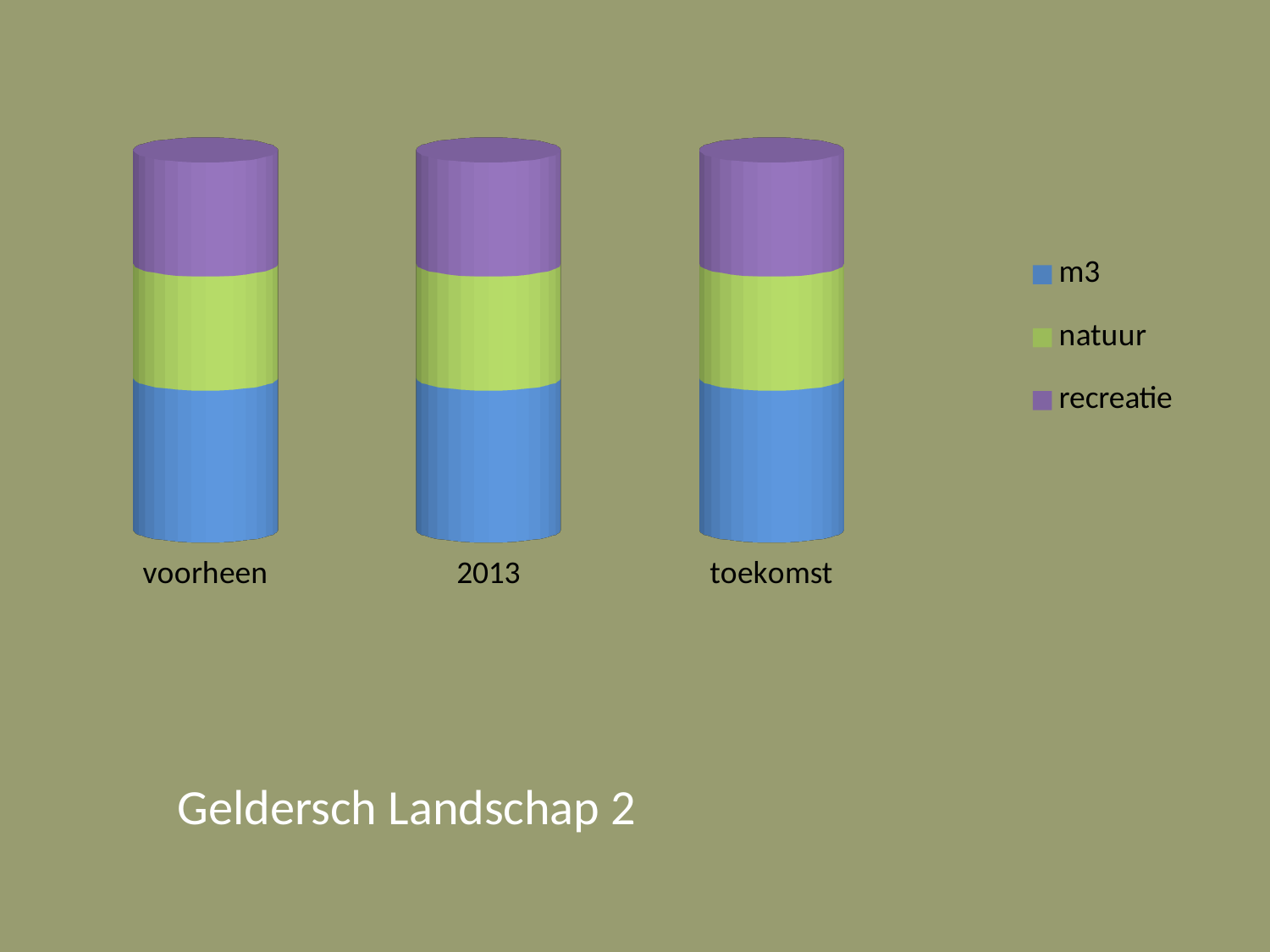
What are the three categories shown along the x axis? voorheen, 2013, toekomst How many categories are shown along the x axis of the chart? 3 Which series is shown in blue in the chart? m3 Which series forms the largest segment of the voorheen bar? m3 Which series forms the largest segment of the toekomst bar? m3 How many series does the chart's legend list? 3 In the 2013 bar, which segment is larger: m3 or natuur? m3 Which series is at the top of each stacked bar? recreatie Do the total heights of the bars rise, fall, or stay the same from voorheen to toekomst? stay the same What kind of chart is shown on the slide? stacked bar chart